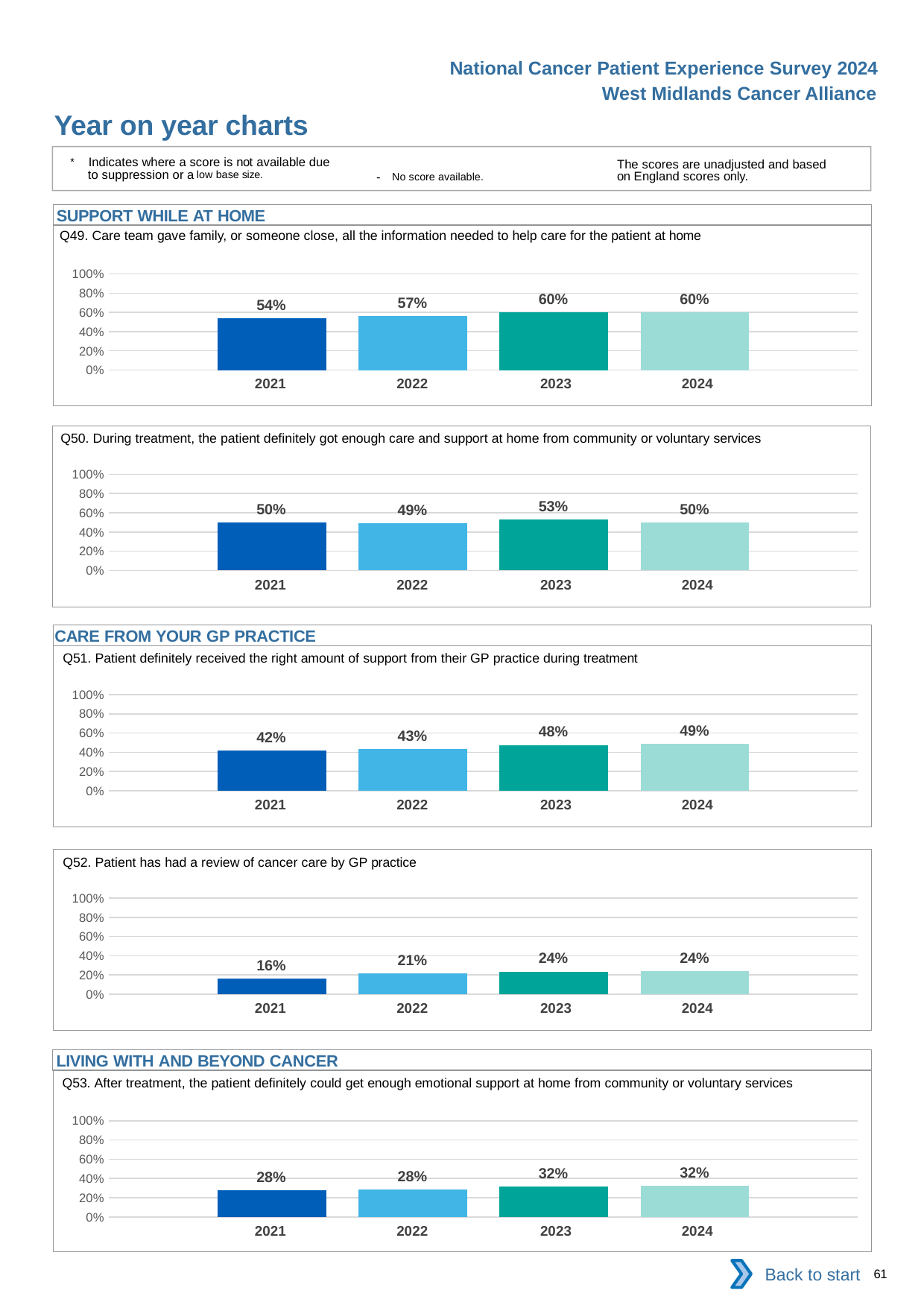
In the Q50 chart, what is the value for 2022? 49% What kind of chart is used for Q52? bar chart In the Q52 chart, what is the difference between the 2023 value and the 2021 value? 8% In the Q53 chart, which is larger, the value for 2022 or the value for 2023? 2023 In the Q50 chart (enough care and support at home from community or voluntary services), which year has the highest value? 2023 How many years are plotted in the Q49 chart? 4 In the Q51 chart, do the values rise or fall from 2021 to 2024? rise In the Q51 chart (right amount of support from GP practice during treatment), which year has the lowest value? 2021 In the Q52 chart (review of cancer care by GP practice), what is the value for 2021? 16% In the Q53 chart (emotional support at home after treatment), is the value for 2024 greater or less than 40%? less In the Q49 chart, what is the difference between the 2024 value and the 2021 value? 6% In the Q49 chart (care team gave family all the information needed to help care for the patient at home), what is the value for 2022? 57%